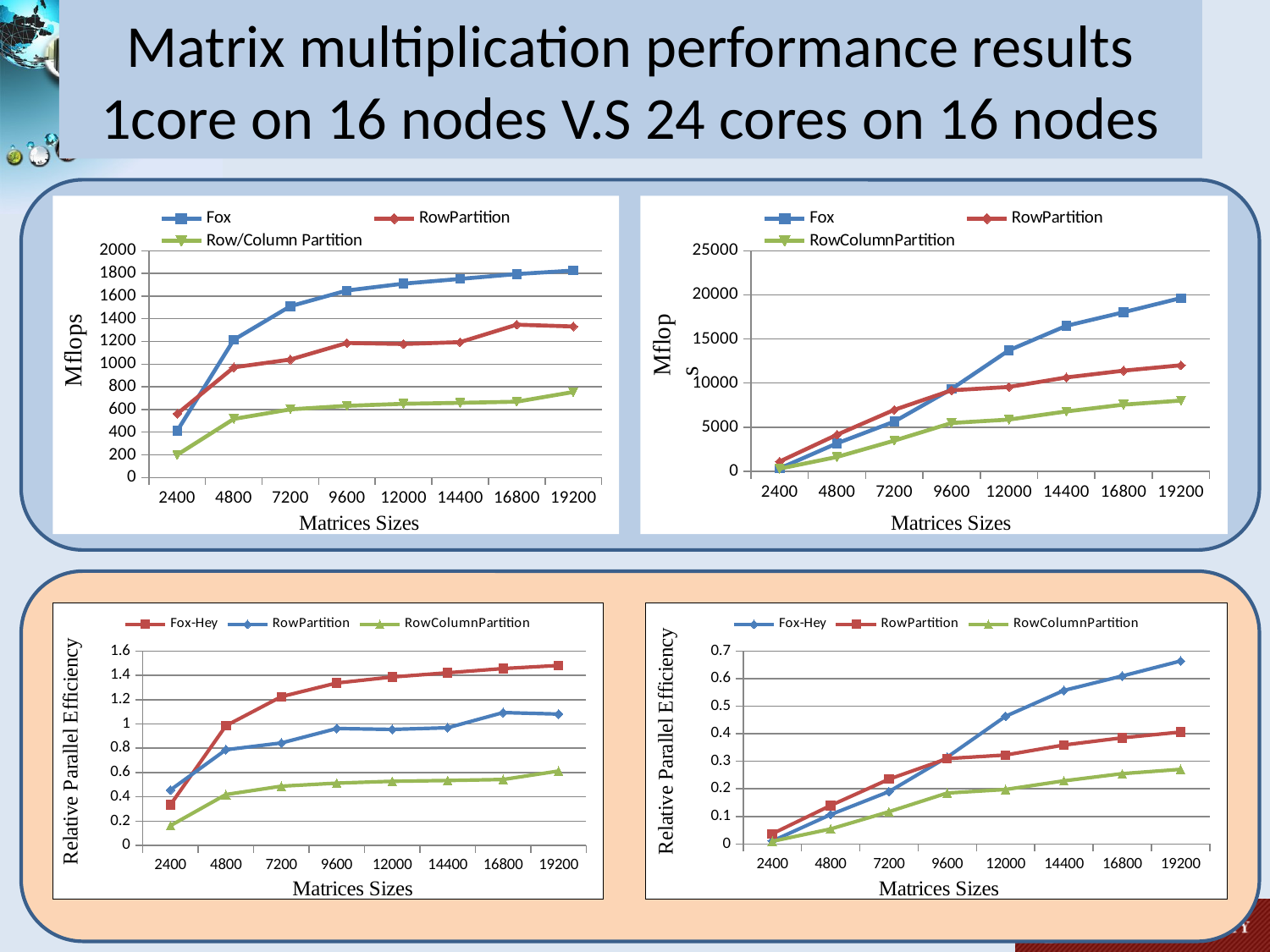
How many matrix sizes are plotted along the x axis of the bottom-left chart? 8 In the top-left chart, how many series does the legend list? 3 In the top-right chart, which series has the highest value at matrix size 2400? RowPartition What type of chart is the bottom-right chart? line chart In the bottom-right chart, is the Fox-Hey value at matrix size 19200 greater or less than 0.6? greater In the top-right chart, is the RowColumnPartition value at matrix size 19200 greater or less than 10000? less In the top-left chart, is the Fox value at matrix size 9600 greater or less than 1400? greater In the bottom-left chart, which series has the highest relative parallel efficiency at matrix size 19200? Fox-Hey In the bottom-left chart, at matrix size 2400, which is larger: Fox-Hey or RowPartition? RowPartition In the top-left chart, which series has the lowest Mflops at matrix size 19200? Row/Column Partition